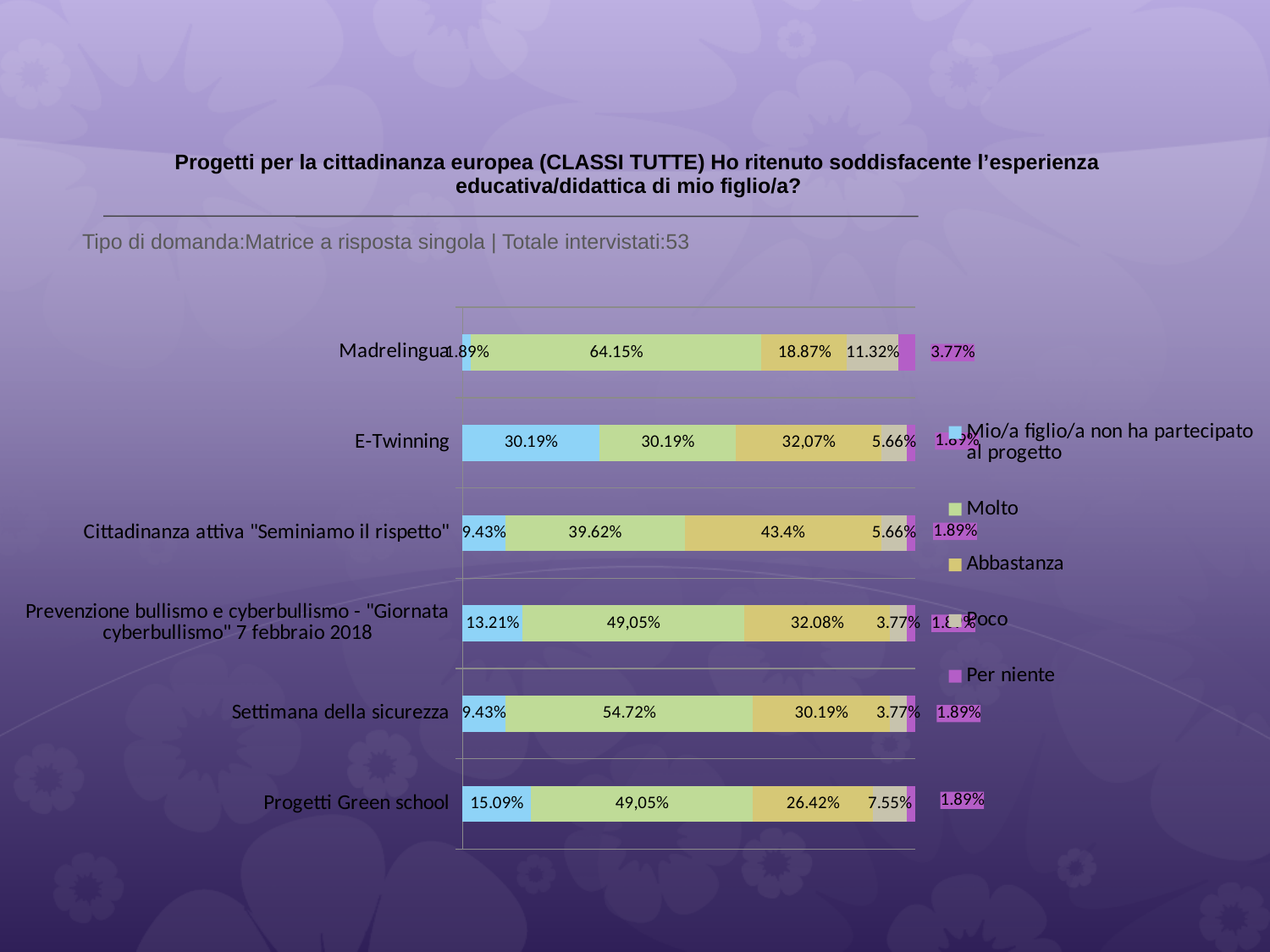
Which project has the lowest "Mio/a figlio/a non ha partecipato al progetto" percentage? Madrelingua What percentage of respondents answered "Molto" for Madrelingua? 64.15% What is the difference between the "Molto" values for Settimana della sicurezza and Cittadinanza attiva "Seminiamo il rispetto"? 15.1% What is the "Molto" value for Settimana della sicurezza? 54.72% What kind of chart is shown on the slide? Stacked bar chart What is the "Poco" value for Progetti Green school? 7.55% What is the "Mio/a figlio/a non ha partecipato al progetto" value for E-Twinning? 30.19% What is the "Abbastanza" value for Cittadinanza attiva "Seminiamo il rispetto"? 43.4% Which project has the highest "Molto" percentage? Madrelingua How many series does the legend list? 5 Which is larger: the "Abbastanza" value for E-Twinning or for Progetti Green school? E-Twinning How many projects (categories) are shown in the chart? 6